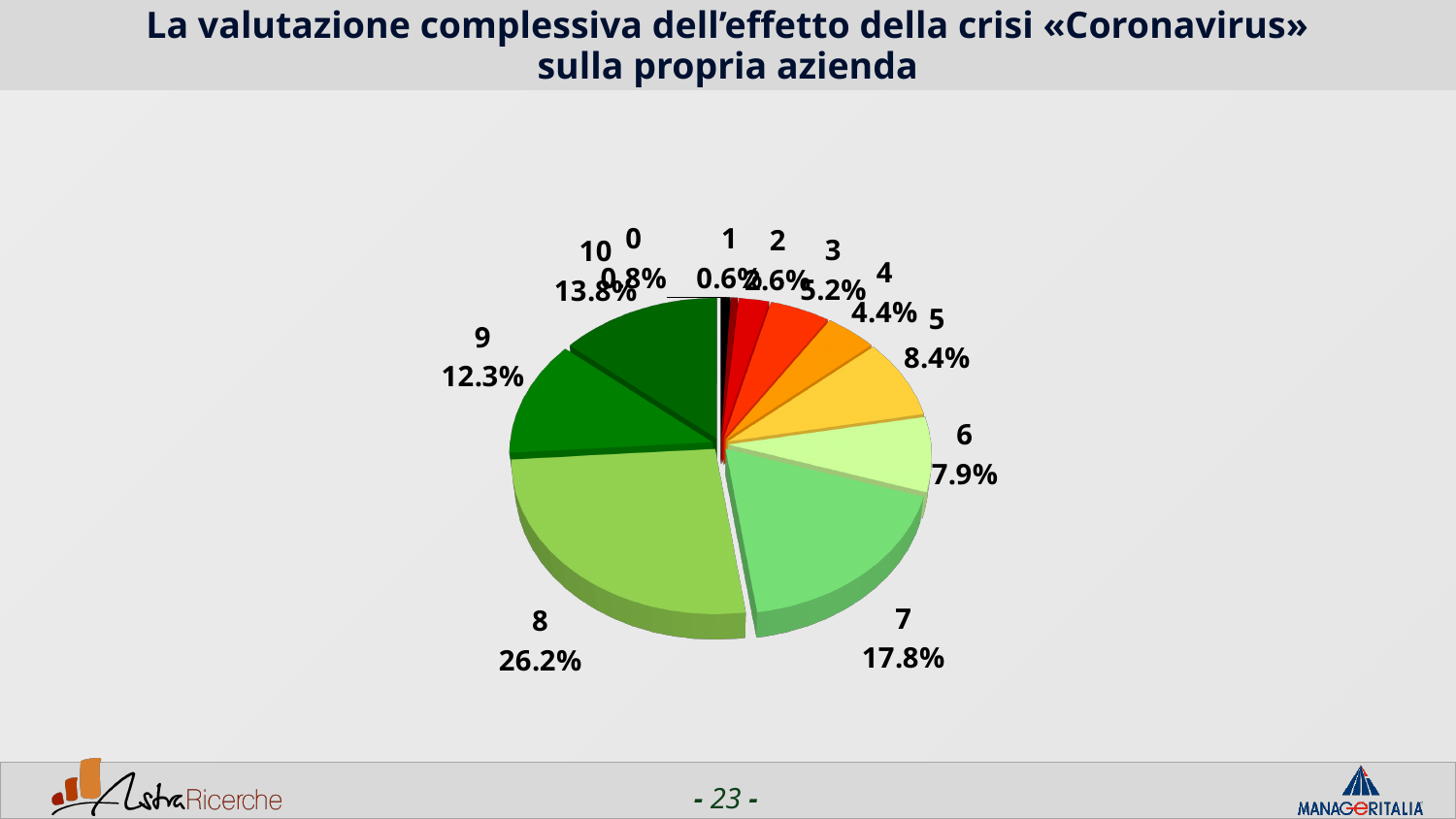
What is the difference between the values for category 8 and category 7? 8.4% What kind of chart is shown on the slide? pie chart How many categories (slices) does the pie chart have? 11 What share of the pie does category 8 have? 26.2% Which category has the smallest slice of the pie? 1 Which category has the largest slice of the pie? 8 What is the value shown for category 7? 17.8% What is the value shown for category 5? 8.4% What is the value shown for category 9? 12.3% What is the value shown for category 3? 5.2% Which has the larger value, category 5 or category 6? 5 What is the value shown for category 4? 4.4%